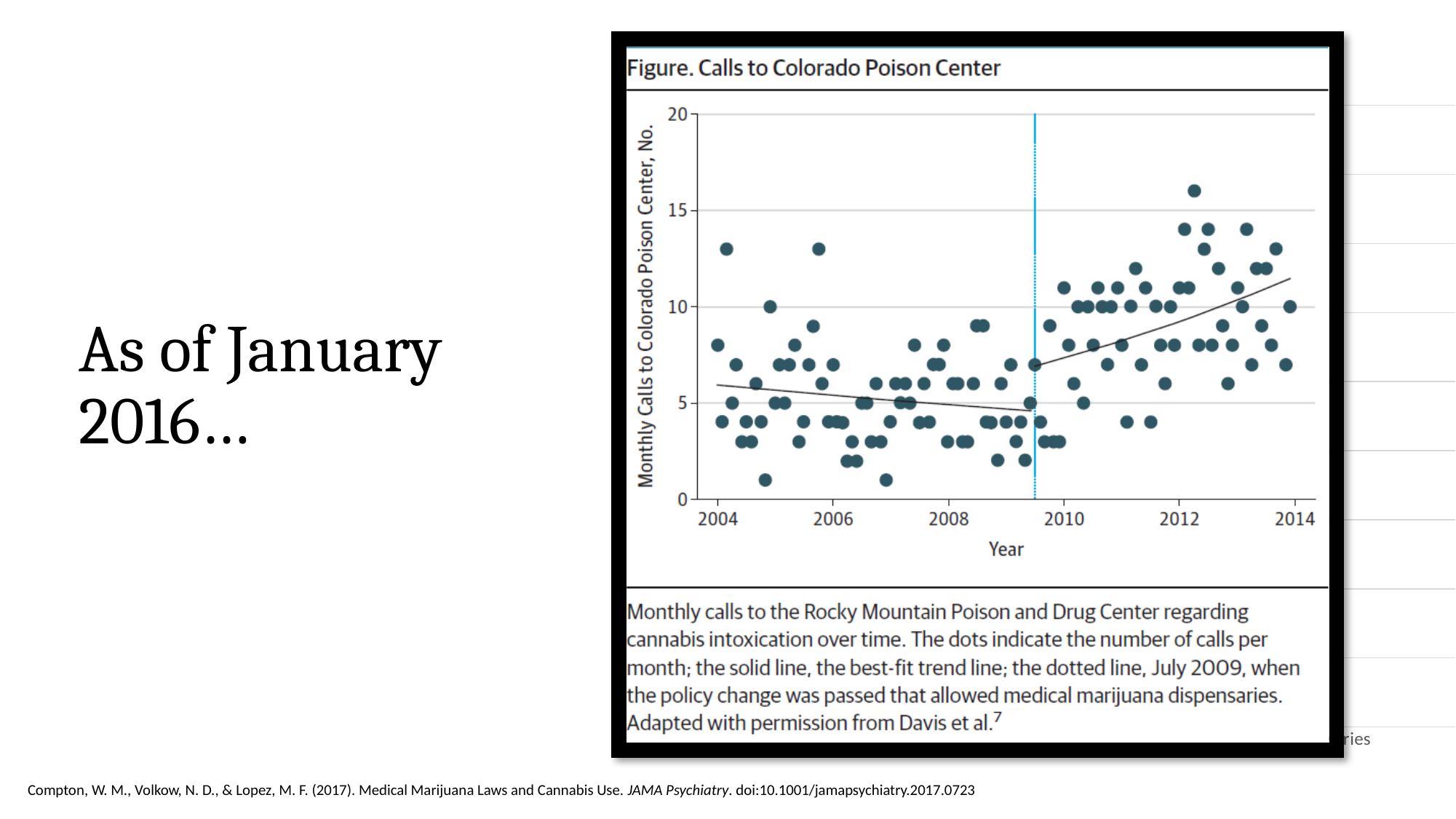
Is the highest monthly call count plotted on the chart greater or less than 15? greater Is the highest monthly call count plotted before 2009 greater or less than 15? less Does the best-fit trend line before the dotted line (2004 to mid-2009) rise or fall over time? Fall Does the best-fit trend line after the dotted line (July 2009) rise or fall over time? Rise What is the title of the figure on the slide? Figure. Calls to Colorado Poison Center Is the lowest monthly call count plotted on the chart greater or less than 5? less Which period has the higher monthly call counts overall: 2004-2006 or 2012-2014? 2012-2014 What kind of chart is shown in the figure 'Calls to Colorado Poison Center'? Scatter plot According to the caption, what does the dotted vertical line in the chart indicate? July 2009, when the policy change allowing medical marijuana dispensaries was passed